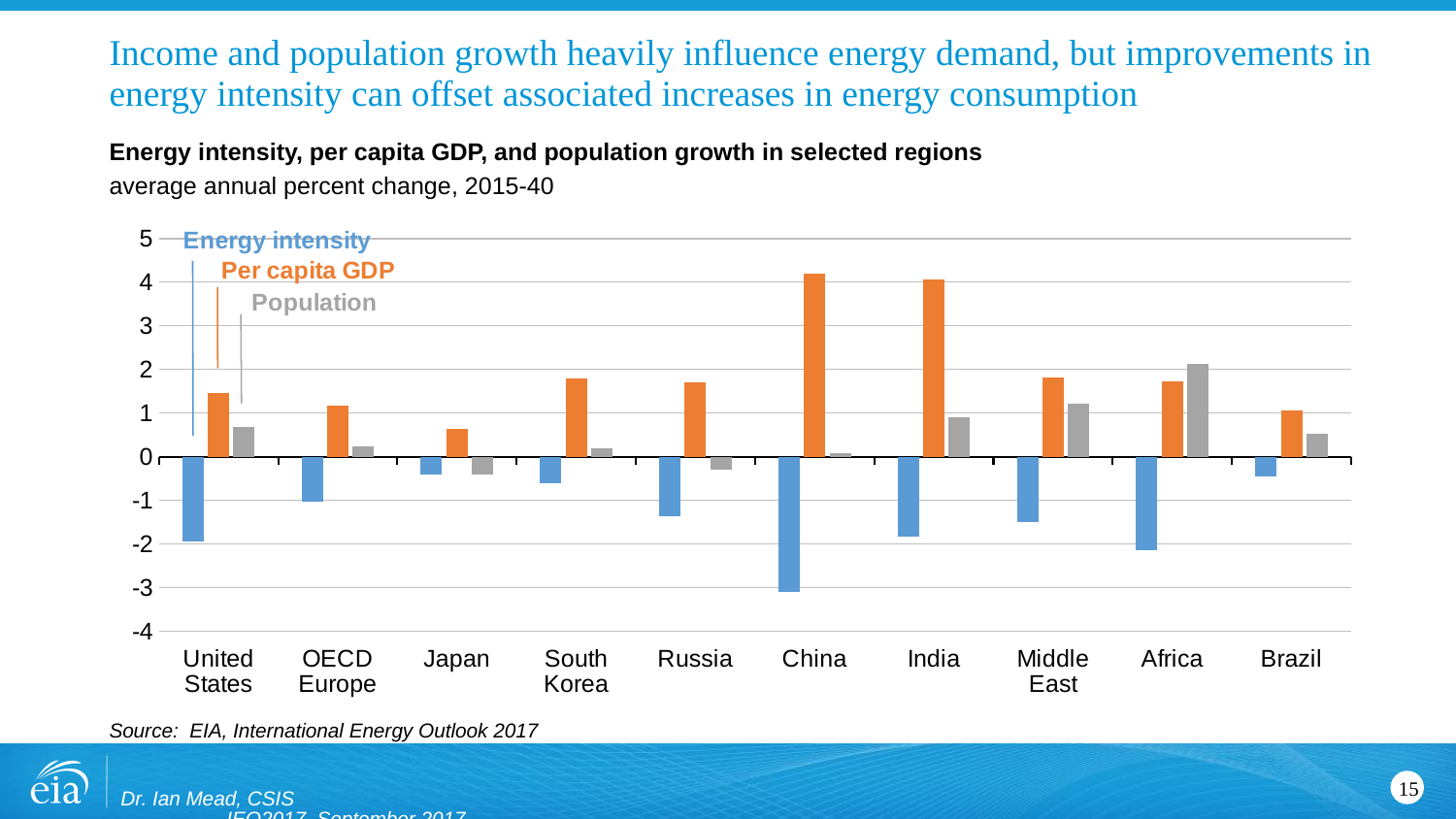
Is the population value for Africa greater or less than 1? greater Which region has the highest population growth in the chart? Africa Is the per capita GDP value for China greater or less than 4? greater How many regions are shown on the x axis of the chart? 10 Which regions show negative population growth in the chart? Japan and Russia What kind of chart is shown on the slide? bar chart Is the energy intensity value for China greater or less than -2? less Which region has the lowest (most negative) energy intensity value in the chart? China For Africa, which is larger: the population bar or the per capita GDP bar? population What colour are the energy intensity bars in the chart? blue How many series does the chart's legend list? 3